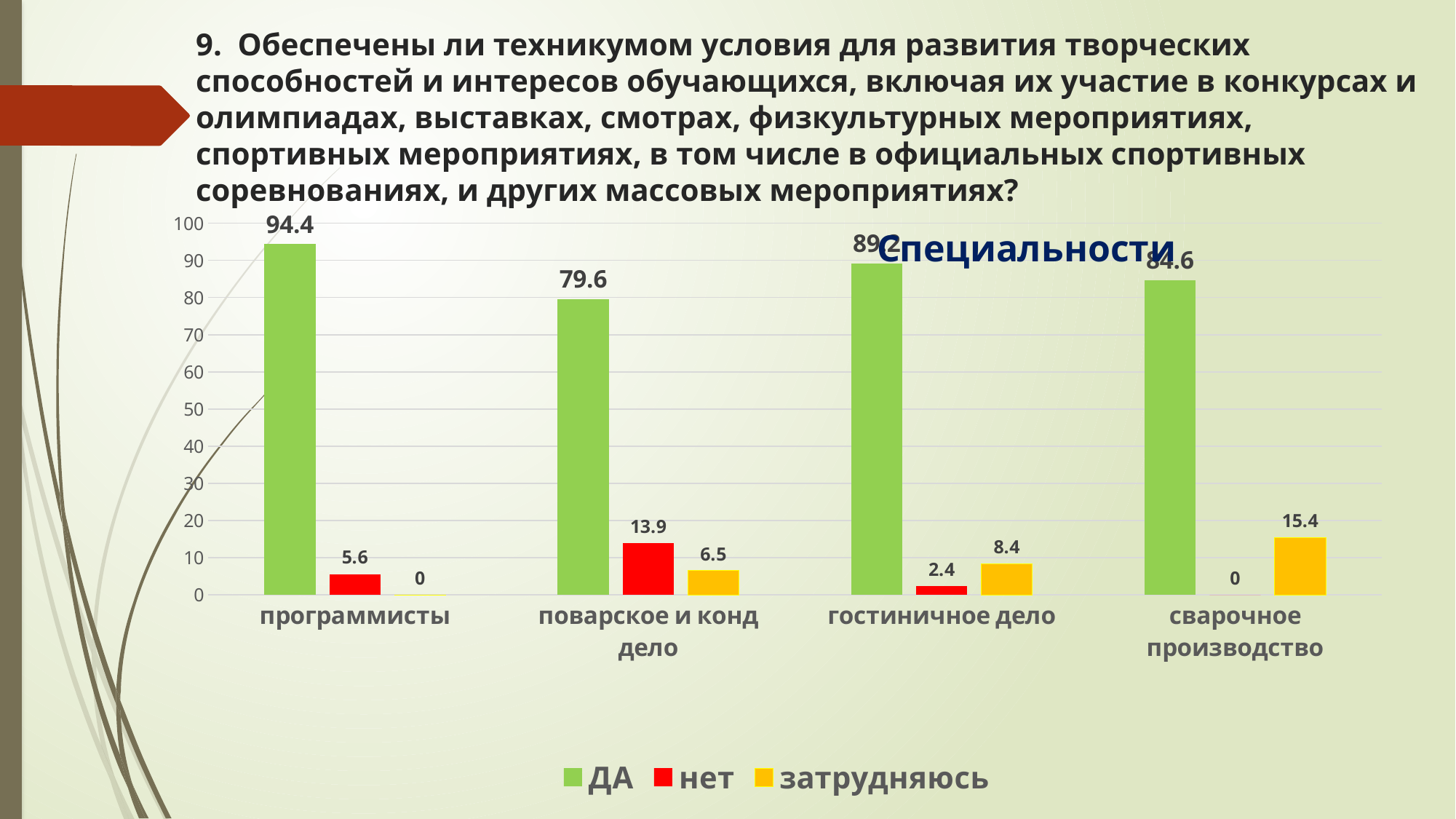
How many series does the legend list? 3 What is the value of затрудняюсь for сварочное производство? 15.4 What is the value of ДА for программисты? 94.4 Which is larger: затрудняюсь for гостиничное дело or затрудняюсь for поварское и конд дело? гостиничное дело Is the ДА value for гостиничное дело greater or less than 80? greater What is the difference between the ДА values for программисты and поварское и конд дело? 14.8 What is the value of нет for гостиничное дело? 2.4 What type of chart is shown on the slide? bar chart Which category has the lowest ДА value? поварское и конд дело Which category has the highest ДА value? программисты What is the value of нет for поварское и конд дело? 13.9 How many categories are shown on the x axis? 4